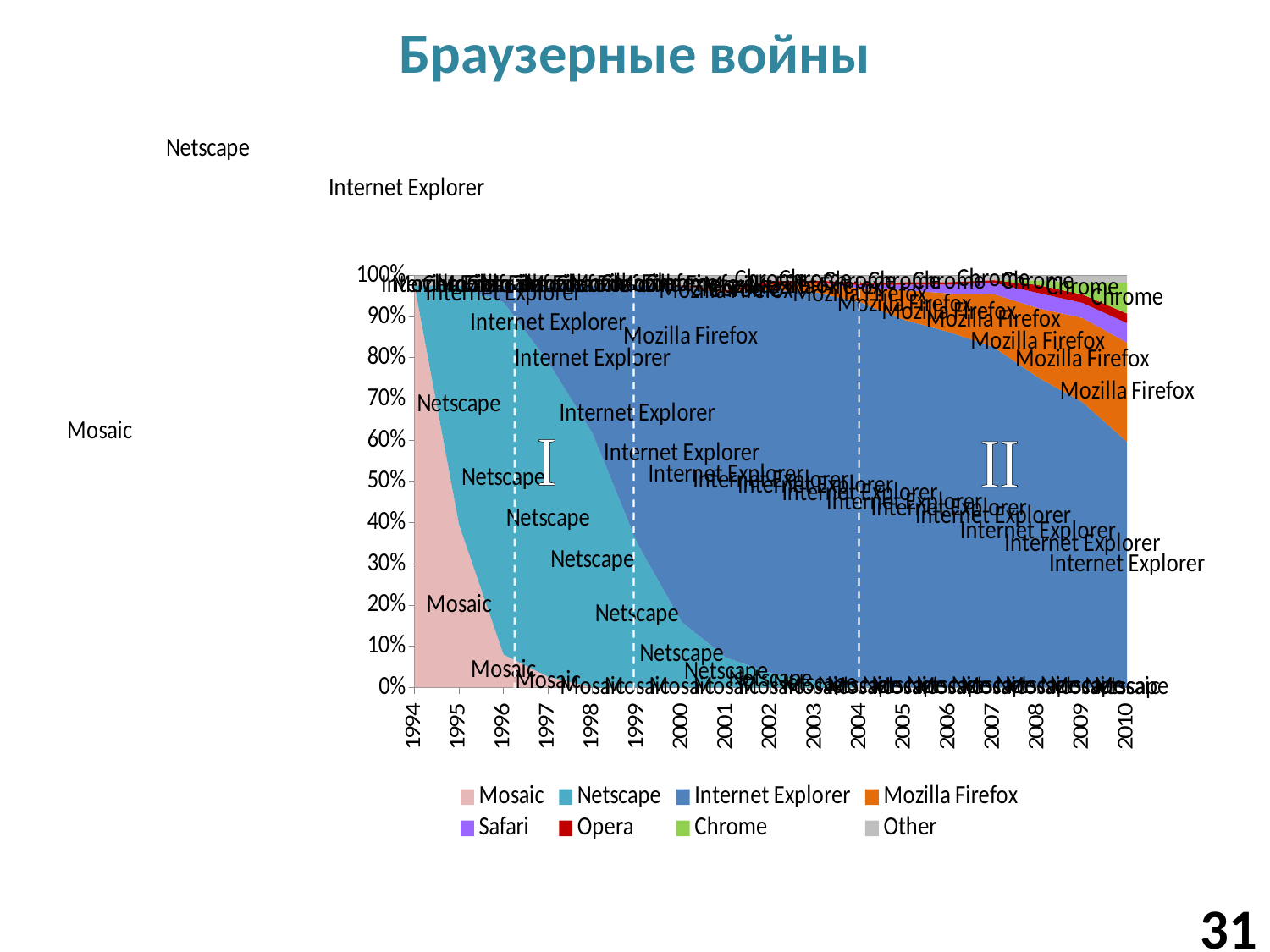
What is the first year shown on the x axis? 1994 Is the share of Internet Explorer in 2010 greater or less than 50%? greater Does the share of Netscape rise or fall from 1996 to 2010? Fall Is the share of Mosaic in 1994 greater or less than 80%? greater Which browser has the largest share in 1994? Mosaic In 2010, which has the larger share, Internet Explorer or Mozilla Firefox? Internet Explorer How many series does the legend list? 8 What is the title of the slide containing the chart? Браузерные войны How many years are shown along the x axis? 17 Is the share of Mozilla Firefox in 2010 greater or less than 20%? greater Which browser has the largest share in 2010? Internet Explorer What type of chart is shown on the slide? Stacked area chart